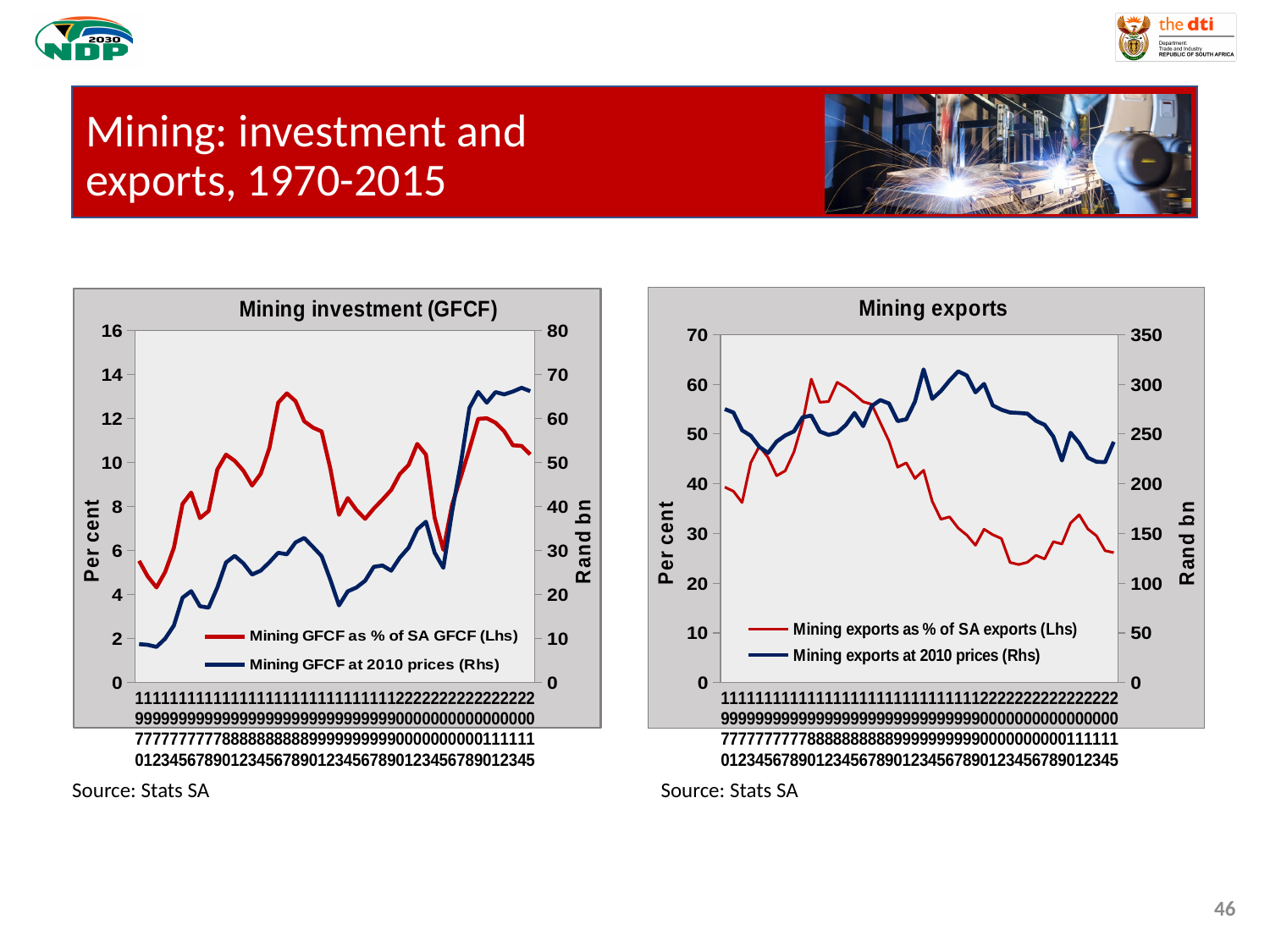
In the "Mining investment (GFCF)" chart, what is the label of the left vertical axis? Per cent In the "Mining exports" chart, what is the label of the right vertical axis? Rand bn In the "Mining investment (GFCF)" chart, is the value of Mining GFCF at 2010 prices in 2015 greater or less than 60? greater How many series does the legend of the "Mining exports" chart list? 2 In the "Mining exports" chart, does Mining exports as % of SA exports overall rise or fall between 1970 and 2015? Fall In the "Mining investment (GFCF)" chart, does Mining GFCF at 2010 prices overall rise or fall between 1970 and 2015? Rise What kind of chart is the "Mining investment (GFCF)" chart? Line chart In the "Mining investment (GFCF)" chart, is the value of Mining GFCF as % of SA GFCF in 1970 greater or less than 8? less In the "Mining exports" chart, is the value of Mining exports as % of SA exports in 1980 greater or less than 50? greater In the "Mining investment (GFCF)" chart, which series is drawn in blue? Mining GFCF at 2010 prices (Rhs) How many years are plotted along the x axis of the "Mining exports" chart? 46